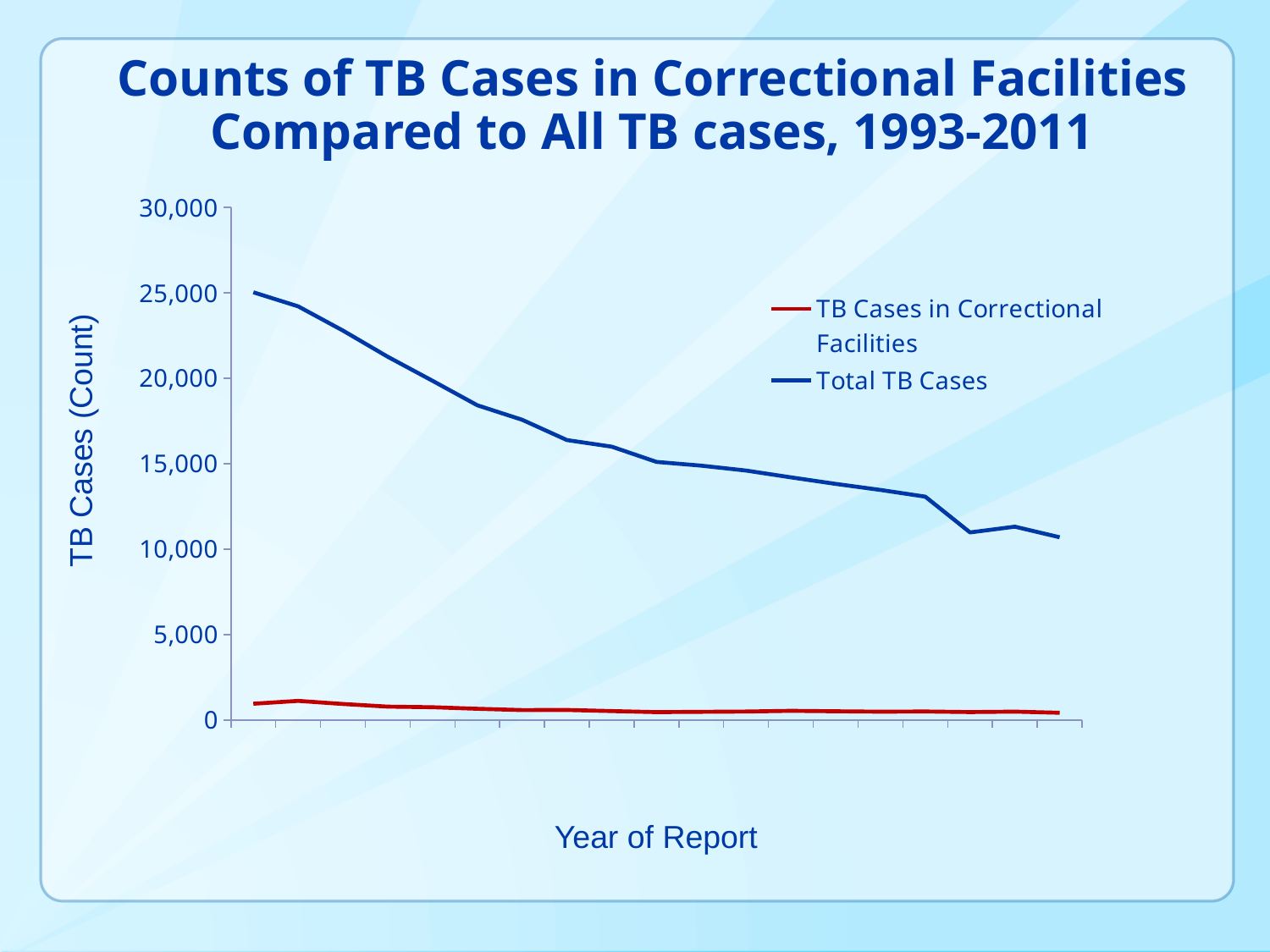
Which series has higher values throughout the chart, TB Cases in Correctional Facilities or Total TB Cases? Total TB Cases What colour is the line for Total TB Cases? blue What is the label of the y axis? TB Cases (Count) Is the rightmost value of the Total TB Cases line greater or less than 15,000? less What is the title of the chart? Counts of TB Cases in Correctional Facilities Compared to All TB cases, 1993-2011 Are any values of the TB Cases in Correctional Facilities line greater than 5,000? no Do the values for Total TB Cases rise or fall from left to right along the x axis? fall Is the rightmost value of the Total TB Cases line greater or less than 10,000? greater What kind of chart is shown on the slide? line chart How many series does the legend list? 2